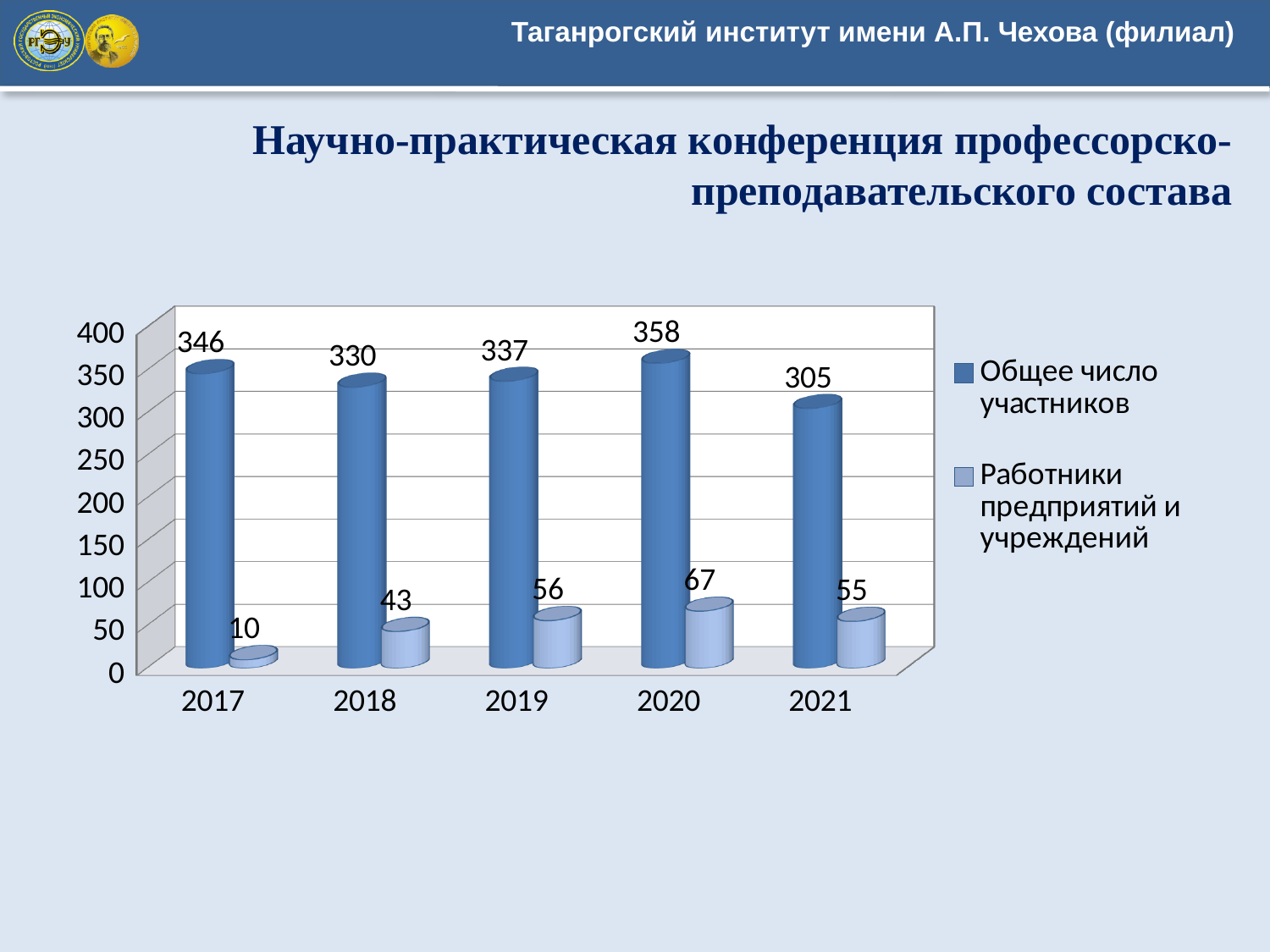
What kind of chart is shown on the slide? bar chart What is the value of "Работники предприятий и учреждений" for 2020? 67 What is the value of "Общее число участников" for 2021? 305 What is the difference between "Общее число участников" in 2020 and in 2021? 53 In which year is "Общее число участников" highest? 2020 Which is larger: "Работники предприятий и учреждений" in 2019 or in 2021? 2019 In which year is "Работники предприятий и учреждений" lowest? 2017 Does "Работники предприятий и учреждений" rise or fall from 2017 to 2020? rise How many series does the legend list? 2 Is the value of "Общее число участников" for 2018 greater or less than 300? greater What is the value of "Общее число участников" for 2017? 346 How many years are shown on the x axis? 5